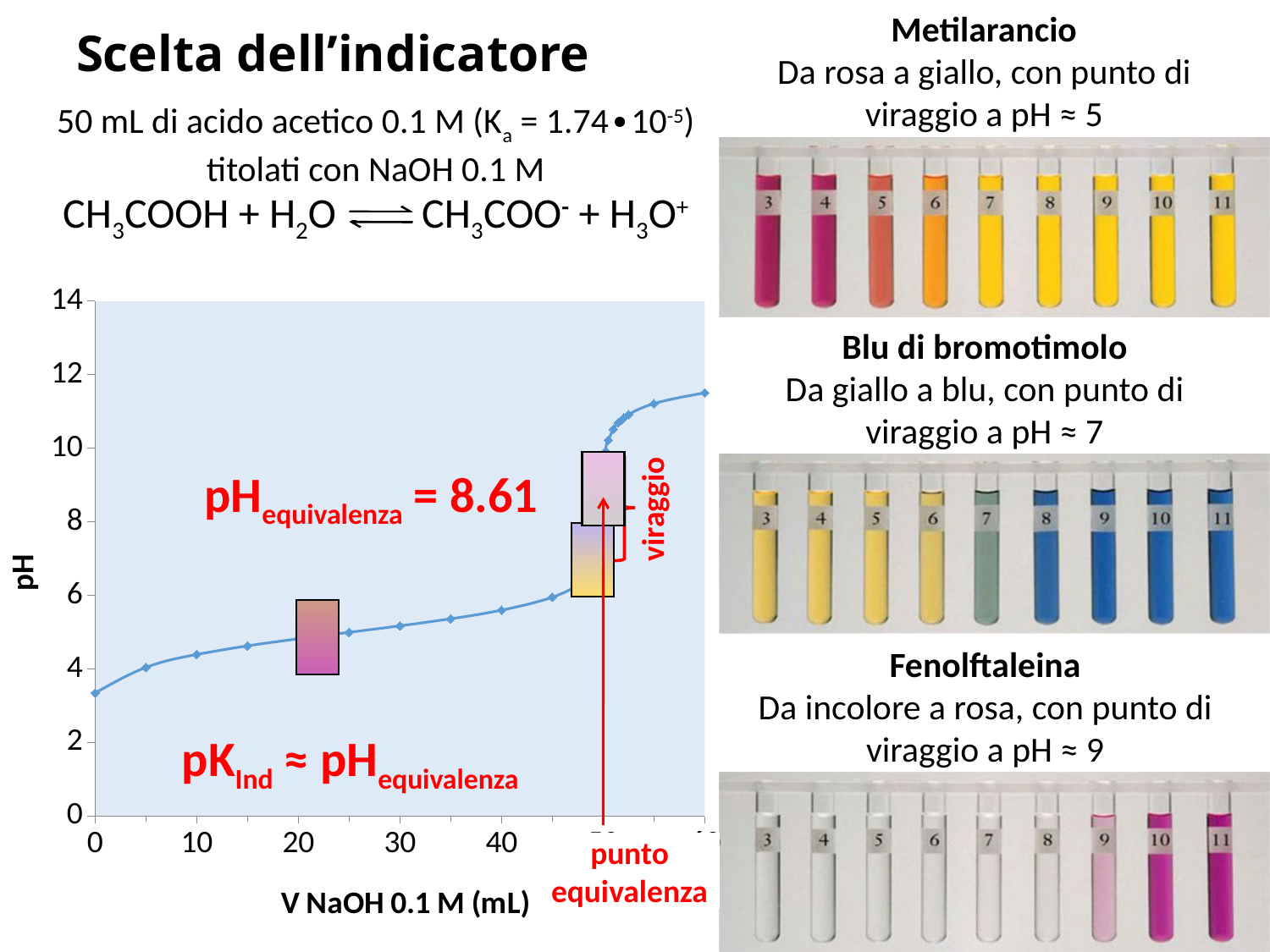
What is the label of the y axis of the chart? pH What is the maximum value shown on the pH axis of the chart? 14 Is the pH at 20 mL of NaOH greater or less than 6? less Is the pH at 40 mL of NaOH greater or less than 6? less Is the pH at 0 mL of NaOH greater or less than 4? less What is the label of the x axis of the chart? V NaOH 0.1 M (mL) What pH value at the equivalence point is annotated on the chart? 8.61 Does the pH rise or fall as the volume of NaOH increases along the x axis? rise What kind of chart is shown on the slide? line chart